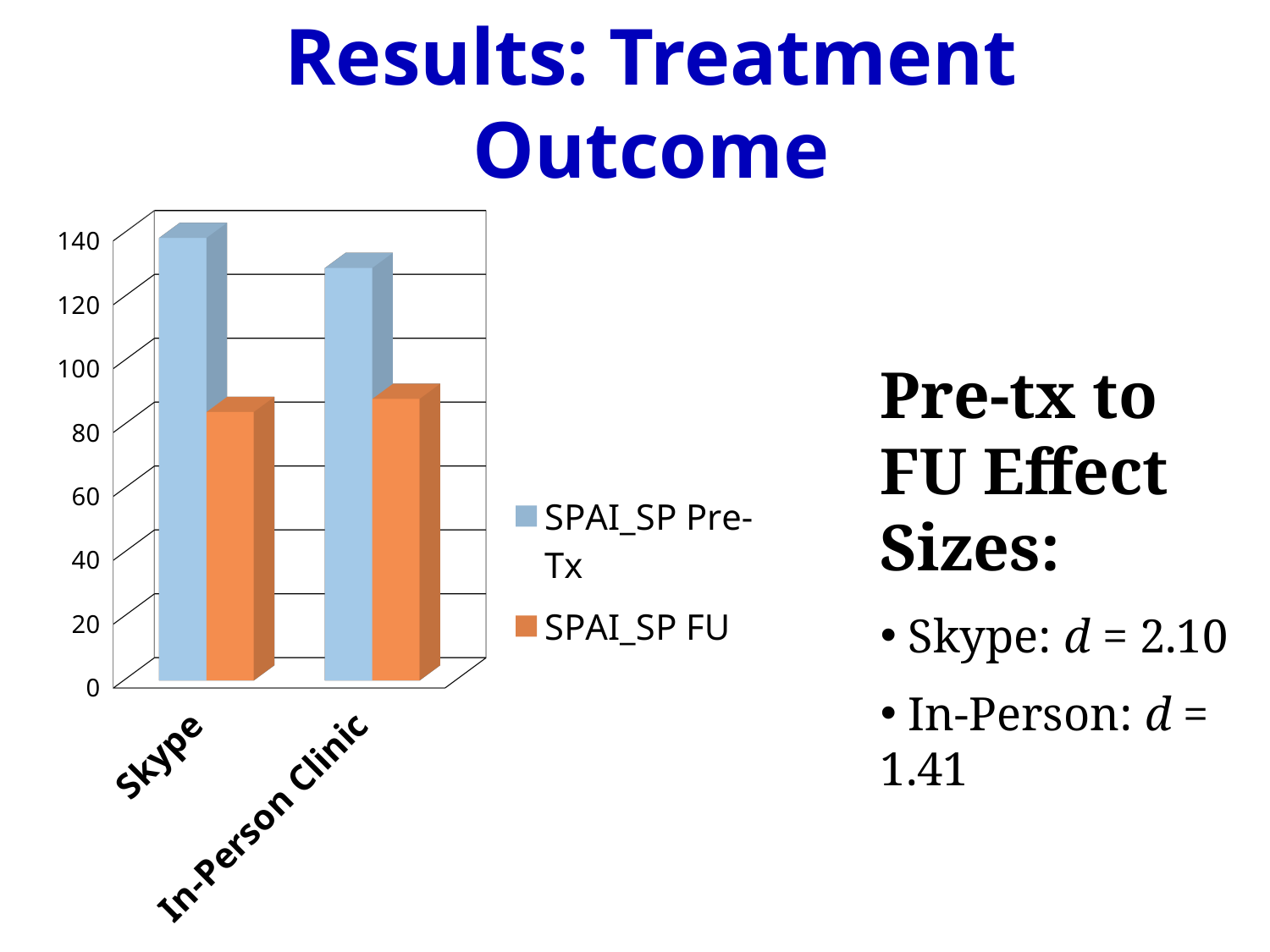
What are the two series named in the chart's legend? SPAI_SP Pre-Tx and SPAI_SP FU For Skype, which is larger: the SPAI_SP Pre-Tx value or the SPAI_SP FU value? SPAI_SP Pre-Tx What kind of chart is shown on the slide? bar chart Is the SPAI_SP FU value for Skype greater or less than 100? less Is the SPAI_SP Pre-Tx value for In-Person Clinic greater or less than 100? greater Is the SPAI_SP Pre-Tx value for Skype greater or less than 120? greater How many categories are shown on the x axis of the chart? 2 How many series does the chart's legend list? 2 Which category has the higher SPAI_SP Pre-Tx value, Skype or In-Person Clinic? Skype For In-Person Clinic, which is larger: the SPAI_SP Pre-Tx value or the SPAI_SP FU value? SPAI_SP Pre-Tx Which colour represents the SPAI_SP FU series in the chart? orange